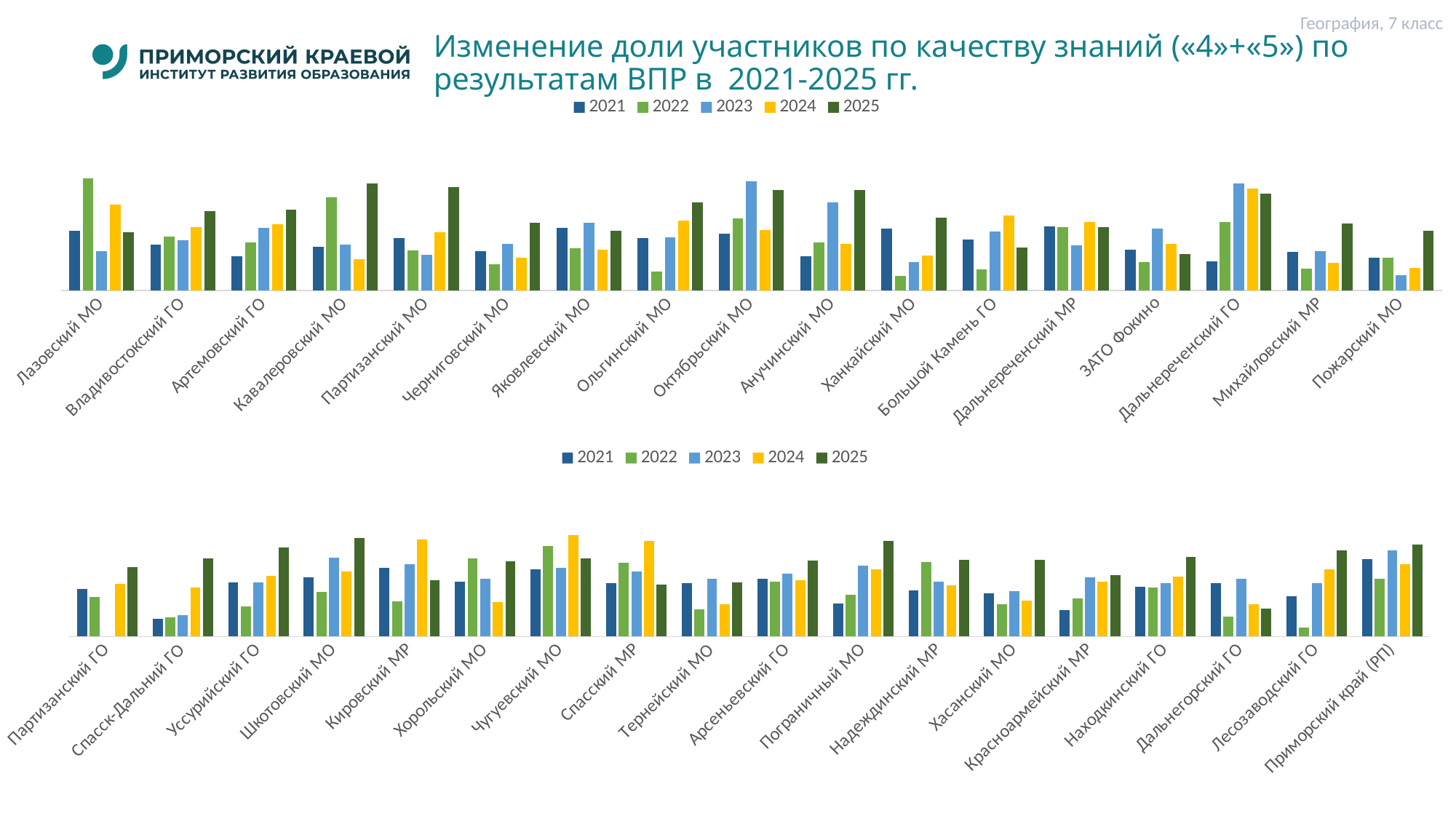
Which subject and grade are indicated in the top right corner of the slide? География, 7 класс In the top chart, for Лазовский МО, which is larger: the 2022 value or the 2023 value? 2022 How many categories are shown on the bottom chart? 18 In the bottom chart, which year has the highest value for Кировский МР? 2024 Which colour represents the 2024 series in the legend? yellow What kind of chart is the top chart on the slide? bar chart How many municipalities (categories) are shown on the top chart? 17 In the top chart, which year has the lowest value for Ханкайский МО? 2022 How many series does the legend of the top chart list? 5 In the bottom chart, for Спасск-Дальний ГО, do the values rise or fall from 2021 to 2025? rise In the bottom chart, which year has the lowest value for Лесозаводский ГО? 2022 In the top chart, which year has the highest value for Лазовский МО? 2022